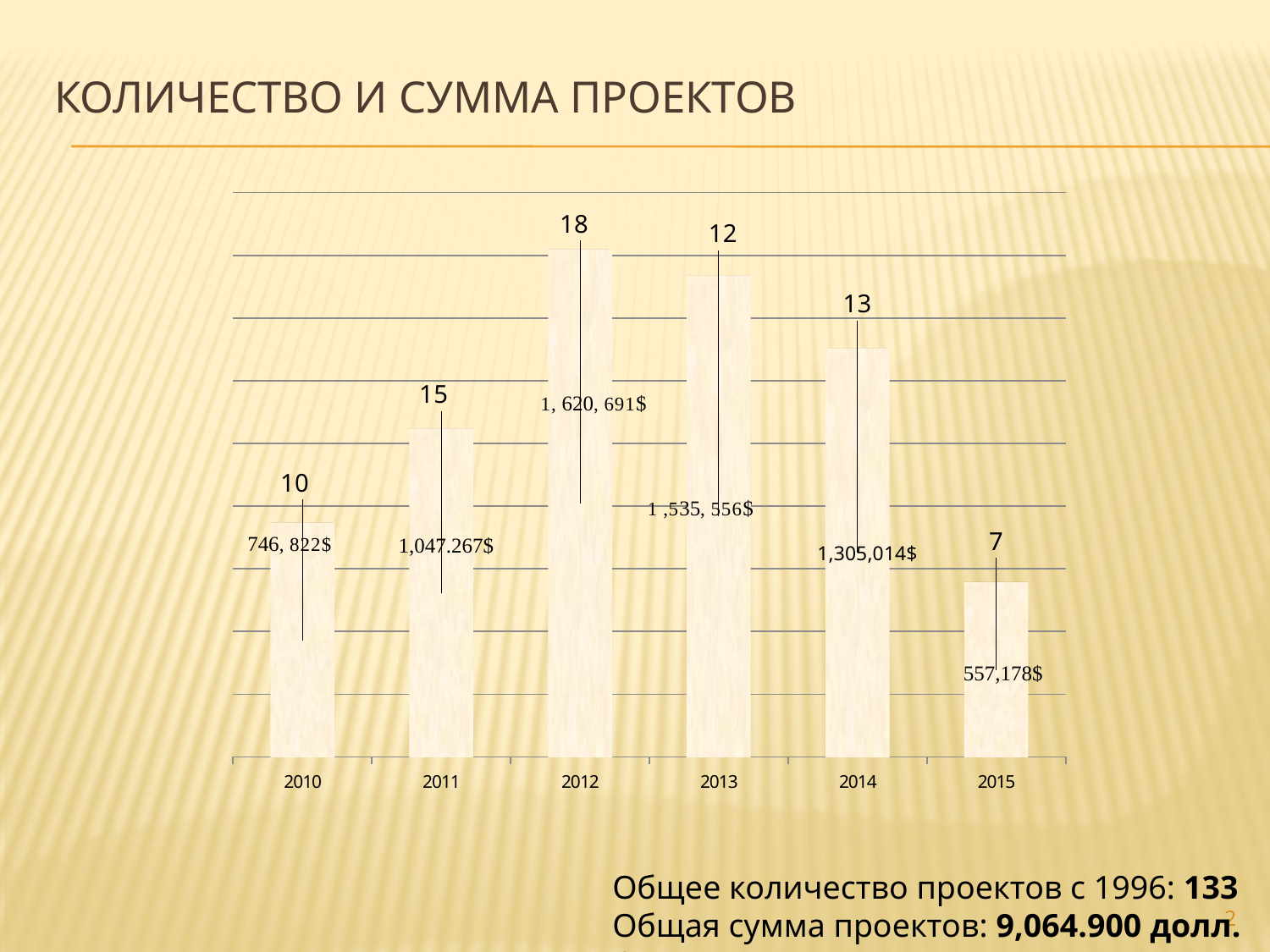
What kind of chart is shown on the slide? bar chart What dollar amount is labelled for 2015? 557,178$ What is the number of projects shown for 2015? 7 Which year has the lowest number of projects? 2015 Which year has the highest number of projects? 2012 What is the number of projects shown for 2010? 10 What dollar amount is labelled for 2014? 1,305,014$ What is the number of projects shown for 2012? 18 What is the difference between the number of projects in 2012 and in 2015? 11 What is the title of the chart on the slide? КОЛИЧЕСТВО И СУММА ПРОЕКТОВ Which year has more projects, 2011 or 2013? 2011 How many years (categories) are shown on the x axis of the chart? 6